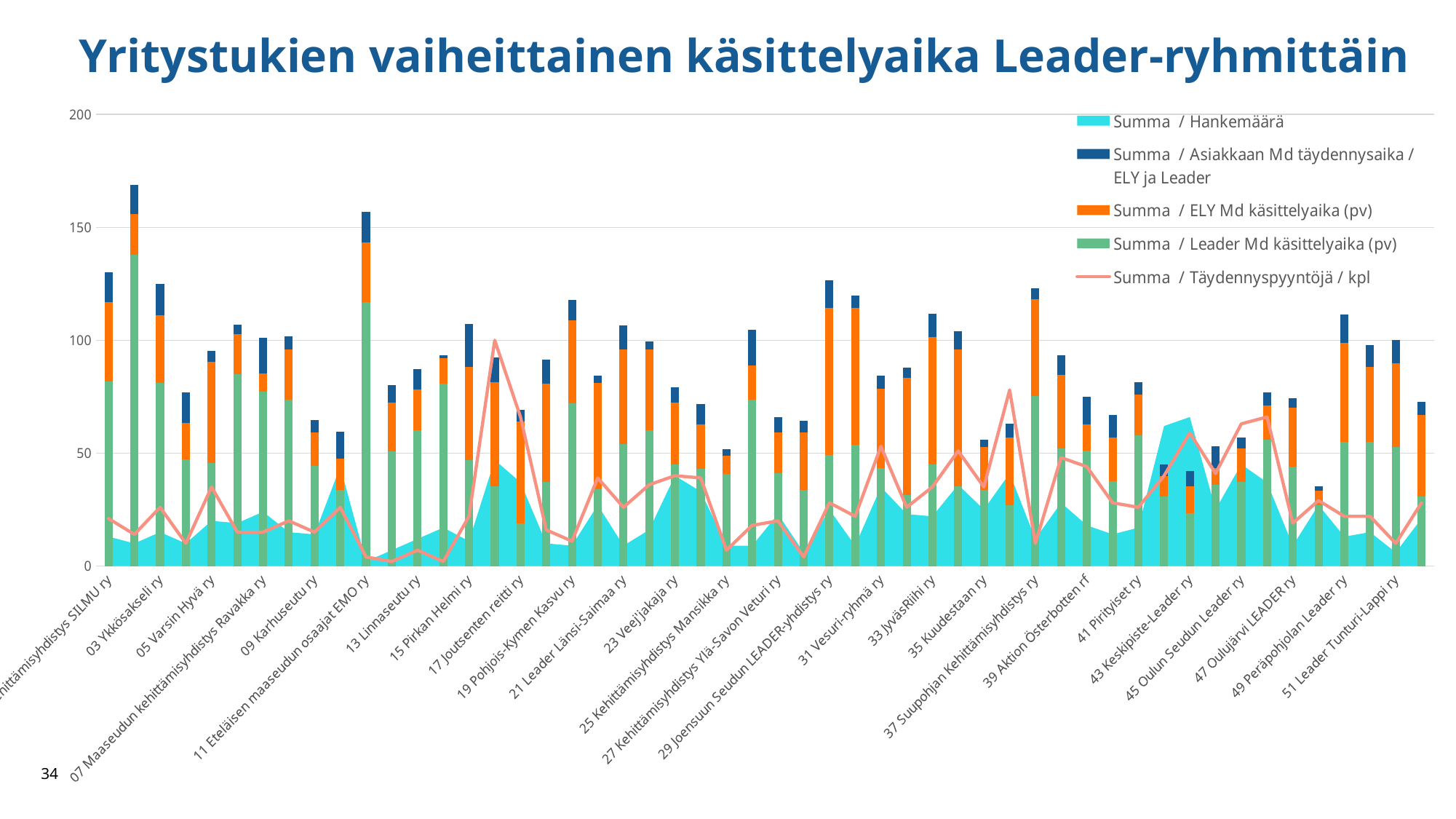
Is the total stacked bar for 19 Pohjois-Kymen Kasvu ry greater or less than 100? greater Is the Summa / Täydennyspyyntöjä / kpl line value for 11 Eteläisen maaseudun osaajat EMO ry greater or less than 50? less Is the total stacked bar for 05 Varsin Hyvä ry greater or less than 100? less How many series does the legend list? 5 Which colour represents the series Summa / ELY Md käsittelyaika (pv)? orange What kind of chart is used for the series Summa / Täydennyspyyntöjä / kpl? line What is the title of the chart? Yritystukien vaiheittainen käsittelyaika Leader-ryhmittäin